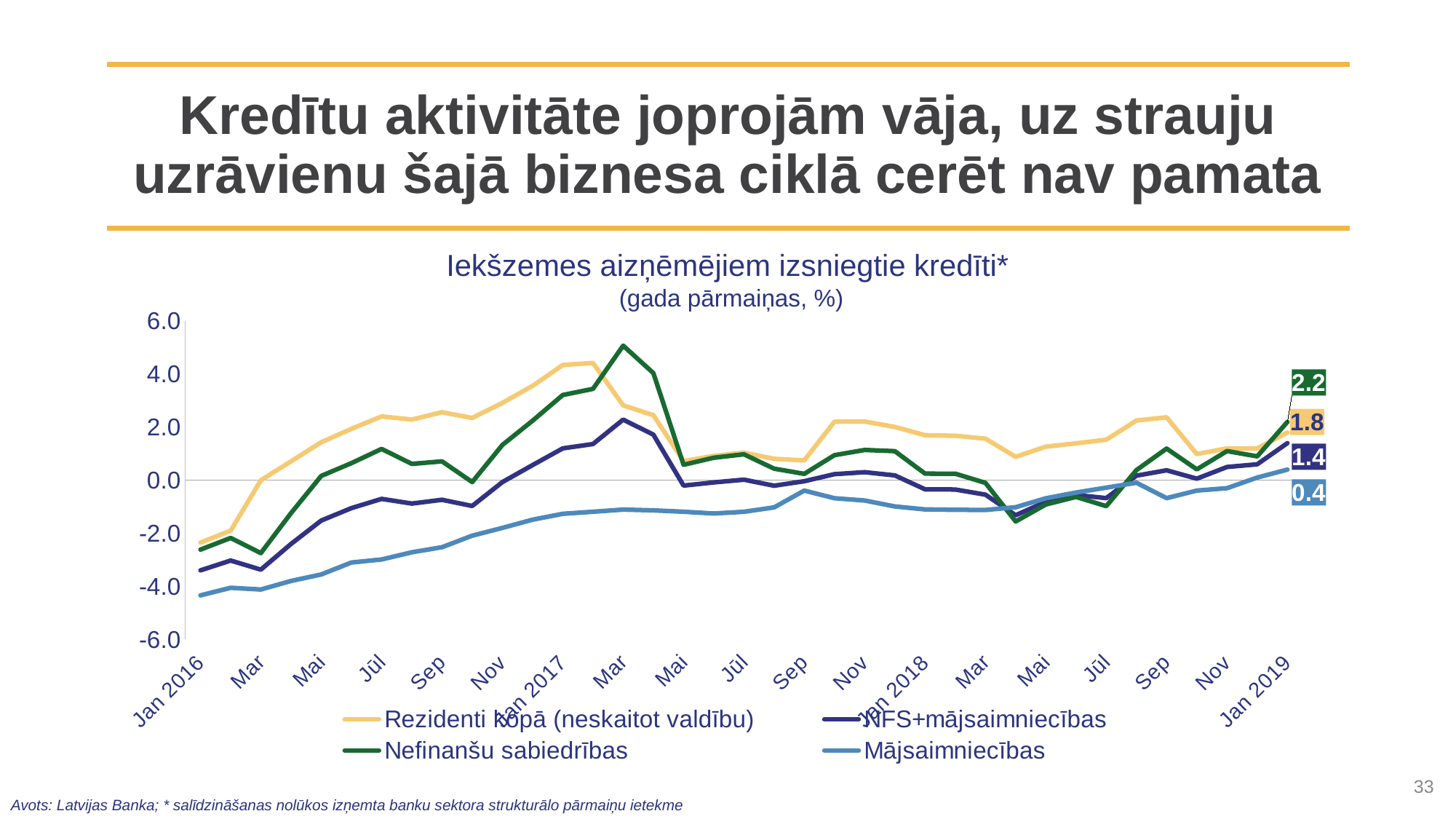
What is the value for Rezidenti kopā (neskaitot valdību) in Jan 2019? 1.8 What is the title of the chart? Iekšzemes aizņēmējiem izsniegtie kredīti* What is the difference between the Jan 2019 values of Nefinanšu sabiedrības and Mājsaimniecības? 1.8 Which series has the lowest value in Jan 2019? Mājsaimniecības How many series does the legend list? 4 Does the Mājsaimniecības line rise or fall overall from Jan 2016 to Jan 2019? rise What kind of chart is shown on the slide? line chart Which series has the highest value in Jan 2019? Nefinanšu sabiedrības Is the value for Mājsaimniecības in Jan 2016 greater or less than -4.0? less What is the value for NFS+mājsaimniecības in Jan 2019? 1.4 What is the value for Nefinanšu sabiedrības in Jan 2019? 2.2 What is the value for Mājsaimniecības in Jan 2019? 0.4